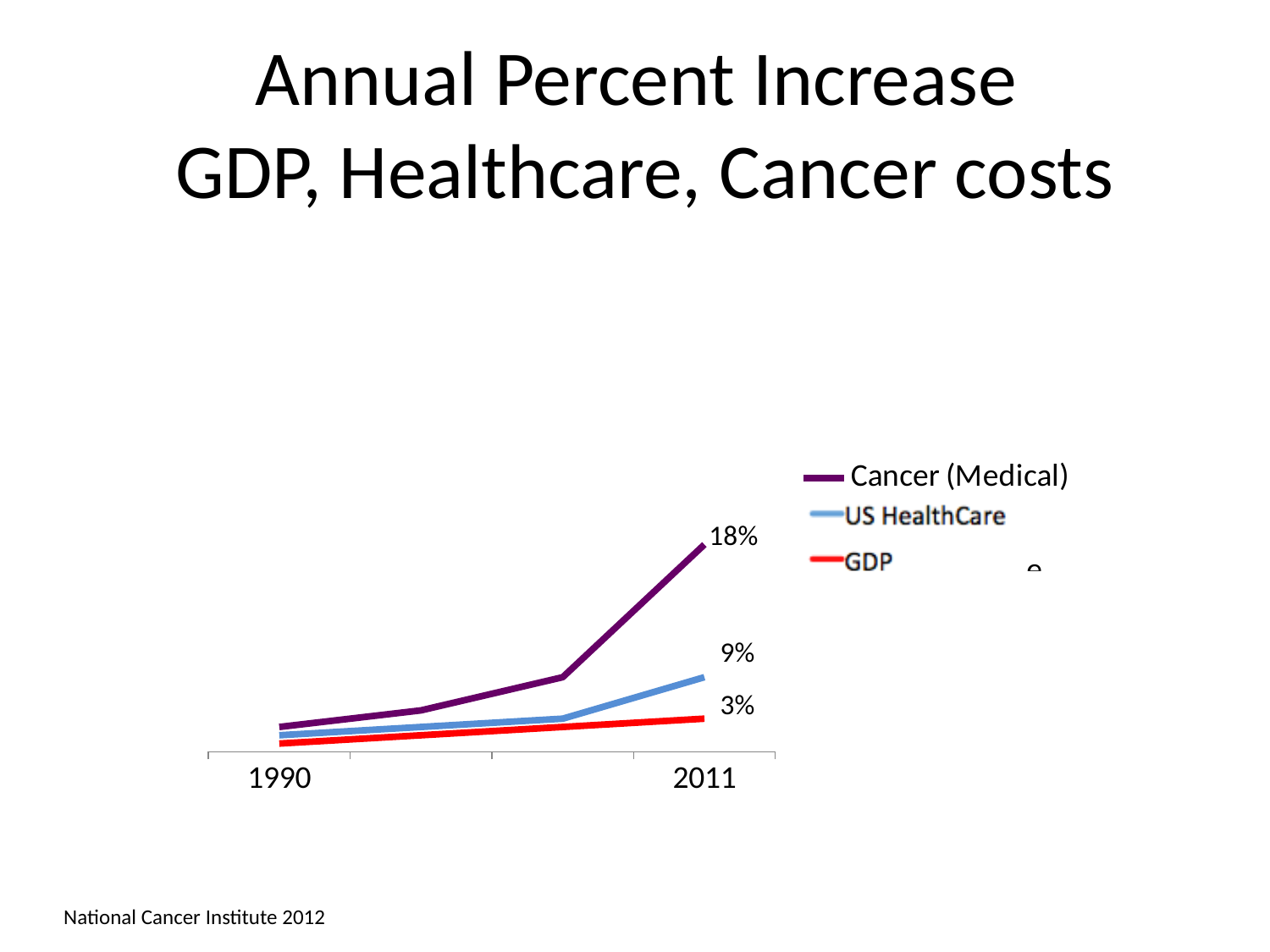
Which series has the highest value in 2011? Cancer (Medical) What is the difference between the US HealthCare and GDP values in 2011? 6% What kind of chart is shown on the slide? line chart Which series has the lowest value in 2011? GDP What is the difference between the Cancer (Medical) and US HealthCare values in 2011? 9% What is the first year labelled on the x axis? 1990 What is the value labelled for Cancer (Medical) in 2011? 18% In 2011, which is larger: the Cancer (Medical) value or the GDP value? Cancer (Medical) What is the value labelled for US HealthCare in 2011? 9% Does the Cancer (Medical) line rise or fall from 1990 to 2011? rise How many series does the legend list? 3 What is the value labelled for GDP in 2011? 3%